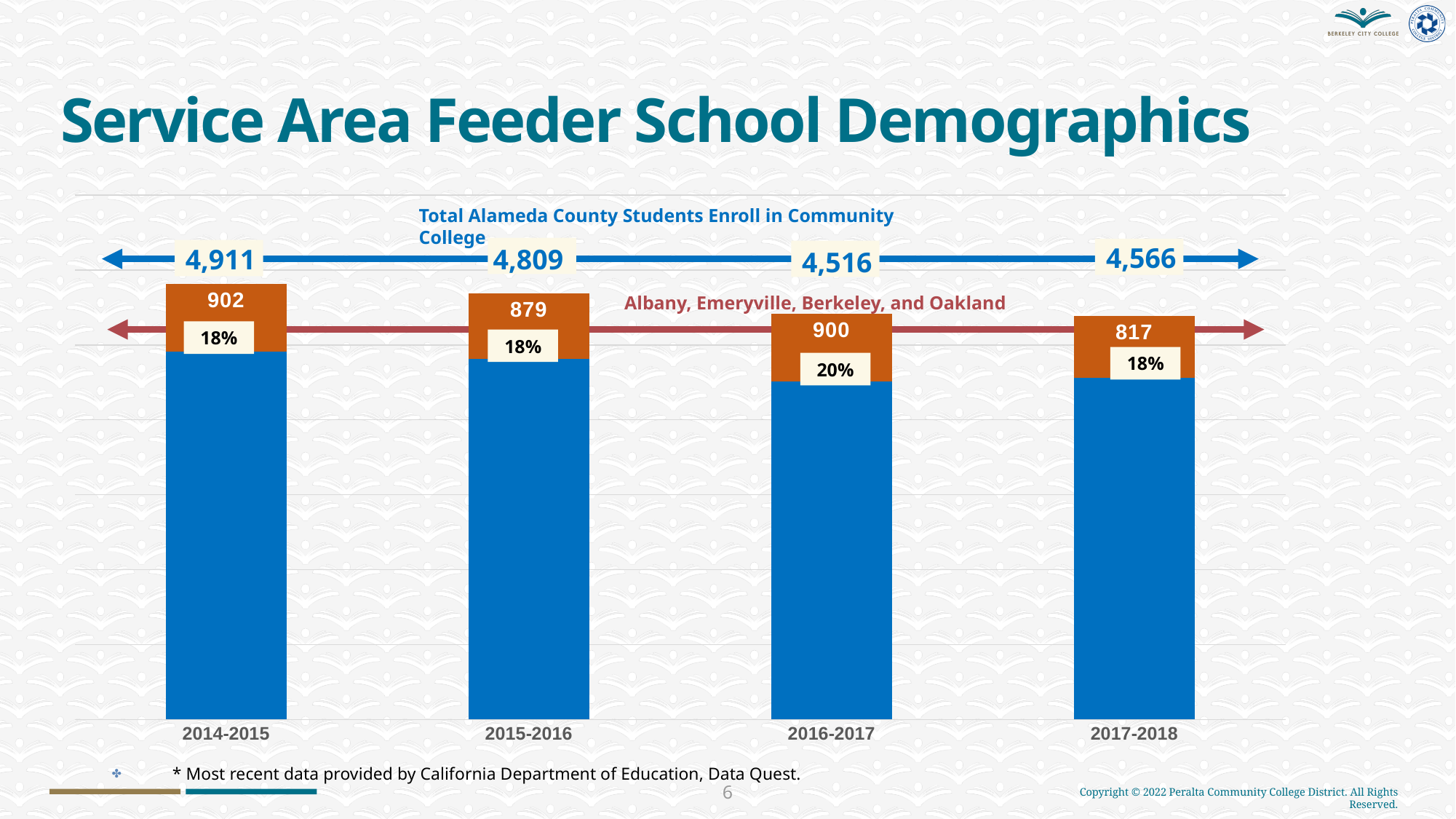
What is the value for Albany, Emeryville, Berkeley, and Oakland in 2014-2015? 902 What is the difference between the Albany, Emeryville, Berkeley, and Oakland values for 2016-2017 and 2017-2018? 83 What is the total Alameda County students enrolled in community college for 2014-2015? 4,911 What percentage is shown for 2016-2017? 20% Which is larger, the Albany, Emeryville, Berkeley, and Oakland value for 2015-2016 or for 2016-2017? 2016-2017 What is the value for Albany, Emeryville, Berkeley, and Oakland in 2017-2018? 817 Which year has the highest value for Albany, Emeryville, Berkeley, and Oakland? 2014-2015 What is the total Alameda County students enrolled in community college for 2016-2017? 4,516 What is the difference between the total Alameda County values for 2014-2015 and 2015-2016? 102 Which year has the lowest total Alameda County students enrolled in community college? 2016-2017 What kind of chart is shown on the slide? Stacked bar chart How many years are shown on the x axis? 4